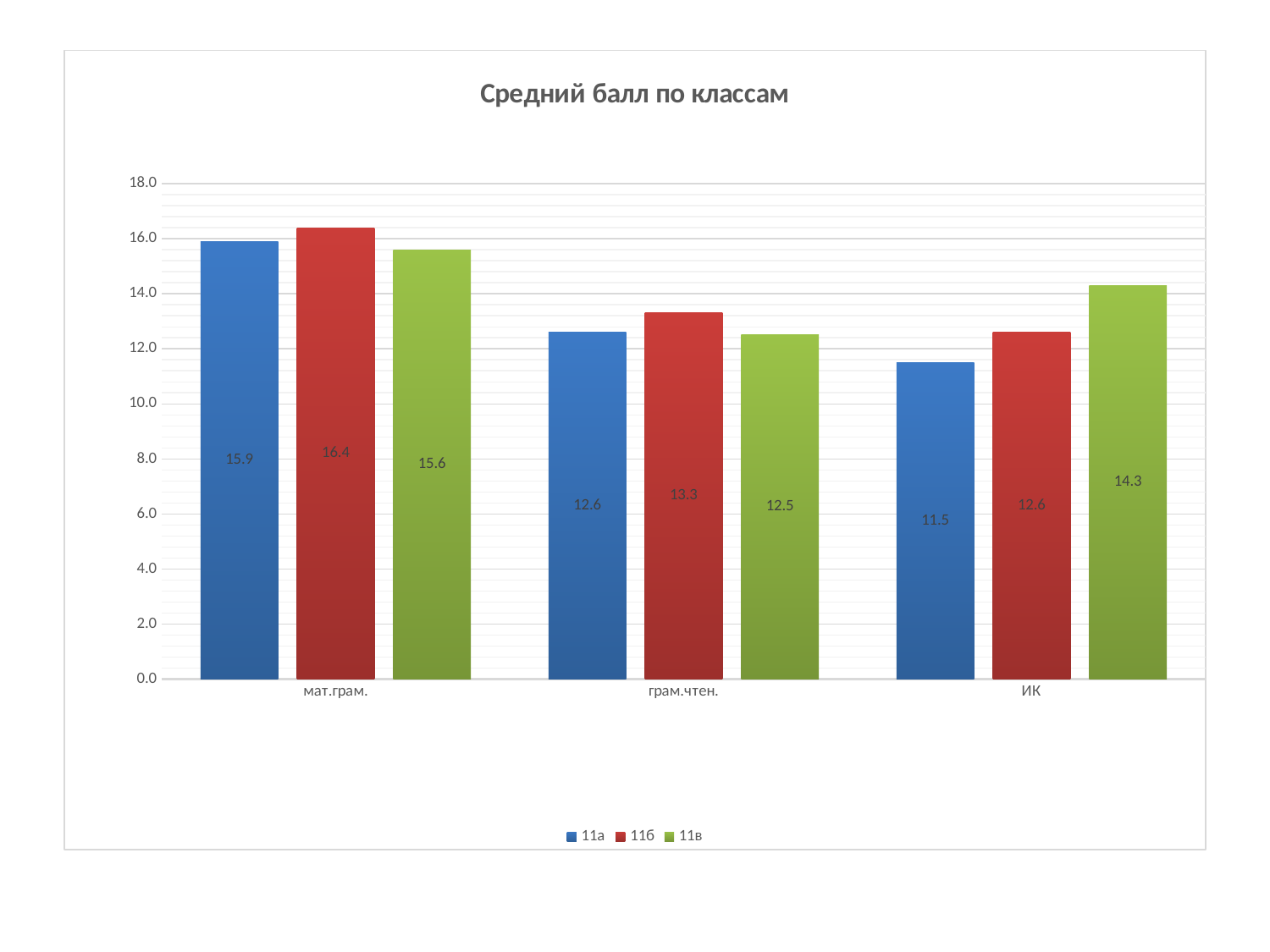
What is the value for 11а in the мат.грам. category? 15.9 What kind of chart is shown? bar chart How many categories are shown on the x axis? 3 What is the difference between the 11б and 11а values in the ИК category? 1.1 What is the title of the chart? Средний балл по классам Which series has the lowest value in the ИК category? 11а Which is larger: the 11в value for мат.грам. or the 11в value for ИК? мат.грам. What is the value for 11б in the грам.чтен. category? 13.3 Which colour represents the 11б series? red How many series does the legend list? 3 Which series has the highest value in the мат.грам. category? 11б What is the value for 11в in the ИК category? 14.3